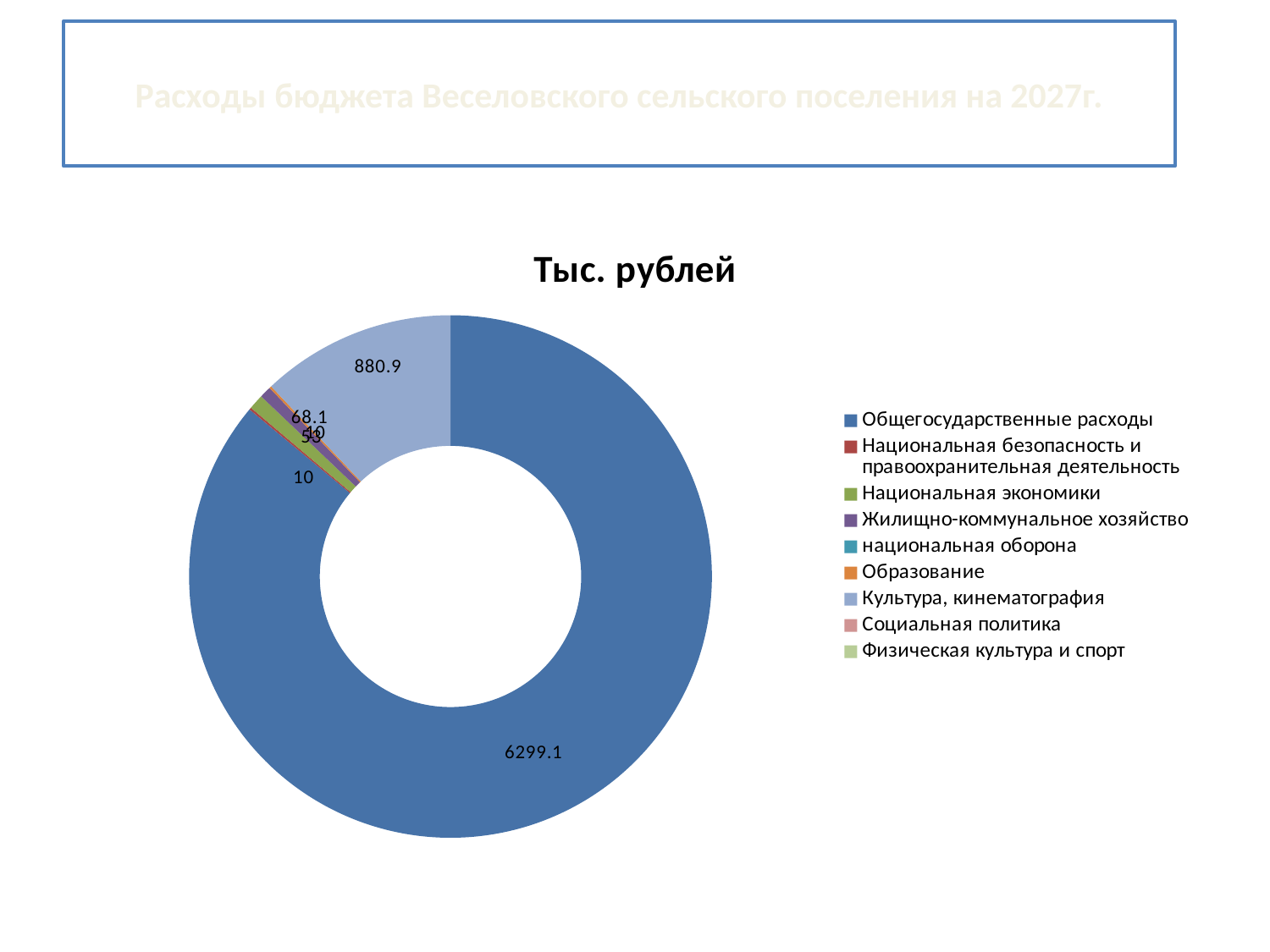
What is the value for Культура, кинематография? 880.9 What is the value for Национальная экономики? 68.1 What is the value for Общегосударственные расходы? 6299.1 Which is larger, Общегосударственные расходы or Культура, кинематография? Общегосударственные расходы How many categories does the chart legend list? 9 What is the difference between Общегосударственные расходы (6299.1) and Культура, кинематография (880.9)? 5418.2 What colour is the slice for Общегосударственные расходы? dark blue What is the title of the chart? Тыс. рублей What kind of chart is shown on the slide? doughnut (pie) chart Is the value for Культура, кинематография greater or less than 1000? less Which category has the largest share of the chart? Общегосударственные расходы What is the difference between Культура, кинематография (880.9) and Национальная экономики (68.1)? 812.8